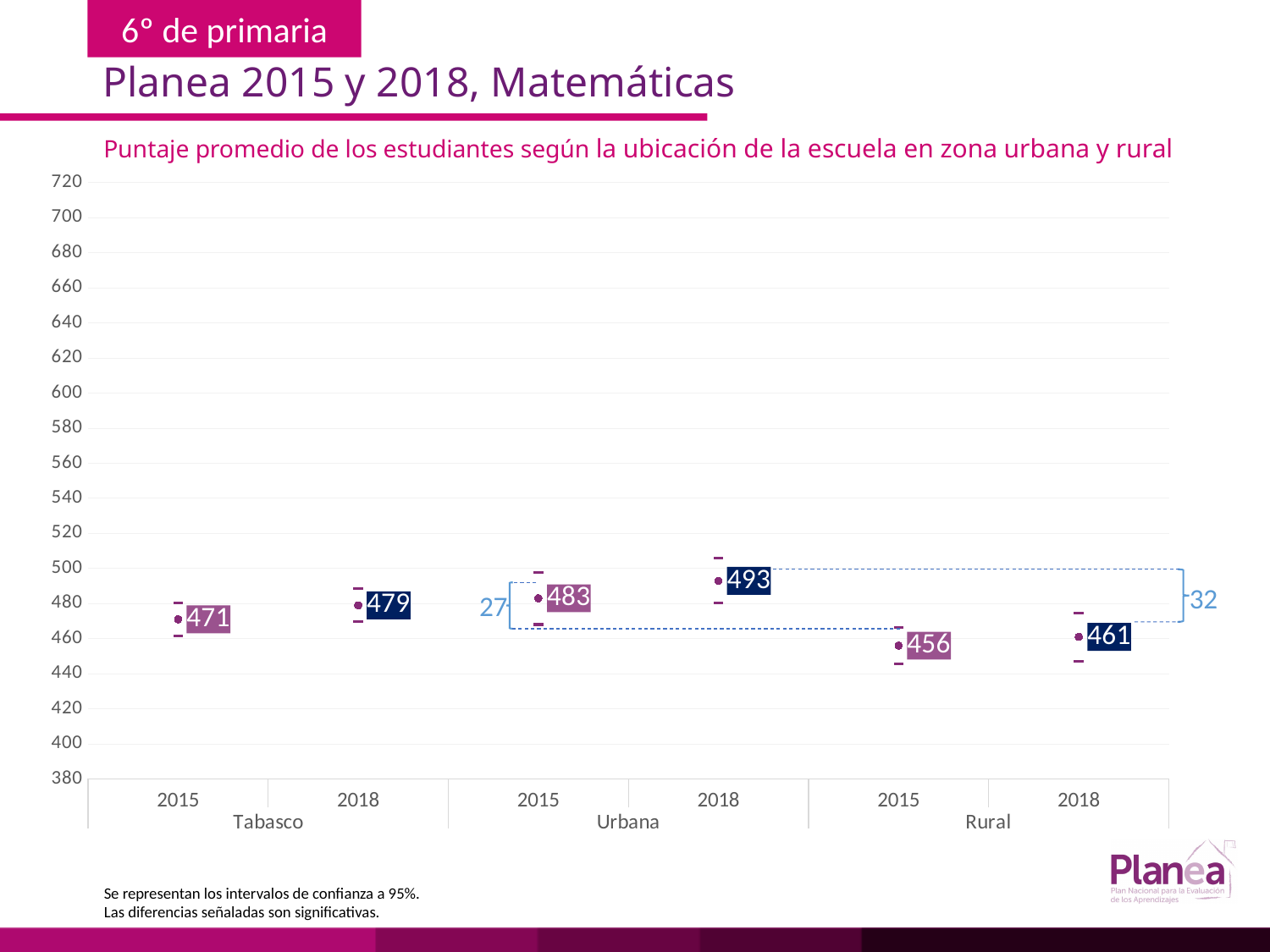
Do the scores rise or fall from 2015 to 2018 for each group? rise Which group and year has the highest average score? Urbana 2018 What is the average score for Rural in 2015? 456 Which is larger, the Urbana score in 2015 or the Tabasco score in 2018? Urbana 2015 How many data points are plotted on the chart? 6 Which group and year has the lowest average score? Rural 2015 What is the average score for Tabasco in 2015? 471 What is the difference between the Tabasco scores in 2018 and 2015? 8 What is the average score for Rural in 2018? 461 What is the difference between the Urbana and Rural scores in 2018? 32 What is the title of the chart? Puntaje promedio de los estudiantes según la ubicación de la escuela en zona urbana y rural What is the average score for Urbana in 2018? 493